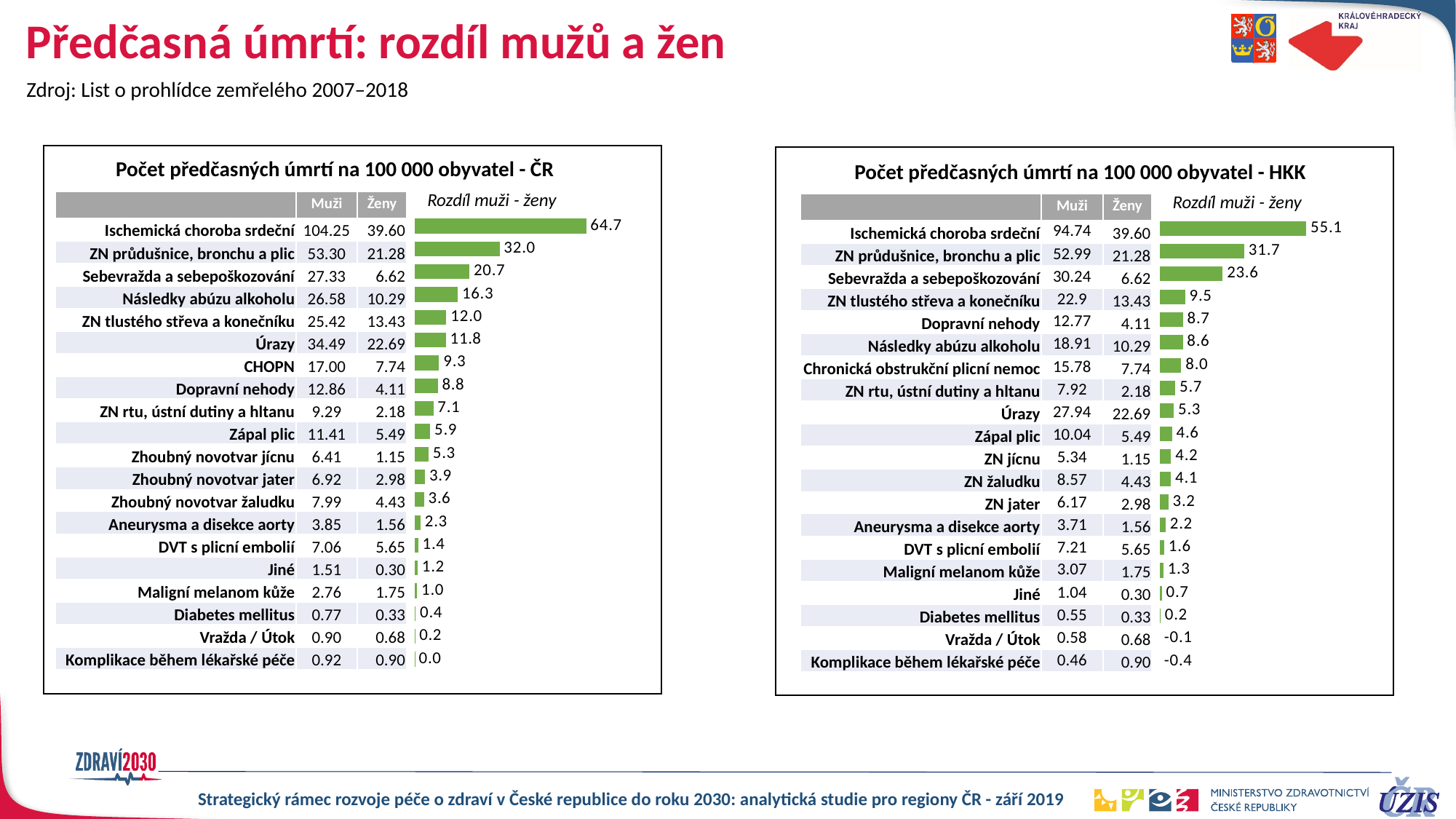
How many categories are shown in the chart 'Počet předčasných úmrtí na 100 000 obyvatel - ČR'? 20 What type of chart is used to show 'Rozdíl muži - ženy' in the chart 'Počet předčasných úmrtí na 100 000 obyvatel - HKK'? Bar chart In the chart 'Počet předčasných úmrtí na 100 000 obyvatel - HKK', how many categories have a negative 'Rozdíl muži - ženy' value? 2 In the chart 'Počet předčasných úmrtí na 100 000 obyvatel - ČR', what is the difference between the 'Rozdíl muži - ženy' values for ZN průdušnice, bronchu a plic and Sebevražda a sebepoškozování? 11.3 What colour are the bars in the chart 'Počet předčasných úmrtí na 100 000 obyvatel - ČR'? Green In the chart 'Počet předčasných úmrtí na 100 000 obyvatel - HKK', which category has the lowest 'Rozdíl muži - ženy' value? Komplikace během lékařské péče In the chart 'Počet předčasných úmrtí na 100 000 obyvatel - ČR', which category has the highest 'Rozdíl muži - ženy' value? Ischemická choroba srdeční In the chart 'Počet předčasných úmrtí na 100 000 obyvatel - ČR', what is the value of 'Rozdíl muži - ženy' for Ischemická choroba srdeční? 64.7 In the chart 'Počet předčasných úmrtí na 100 000 obyvatel - HKK', what is the value of 'Rozdíl muži - ženy' for Sebevražda a sebepoškozování? 23.6 In the chart 'Počet předčasných úmrtí na 100 000 obyvatel - ČR', what is the 'Rozdíl muži - ženy' value for Komplikace během lékařské péče? 0.0 In the chart 'Počet předčasných úmrtí na 100 000 obyvatel - HKK', which is larger: the 'Rozdíl muži - ženy' value for Dopravní nehody or for Úrazy? Dopravní nehody In the chart 'Počet předčasných úmrtí na 100 000 obyvatel - HKK', what is the 'Rozdíl muži - ženy' value for Vražda / Útok? -0.1